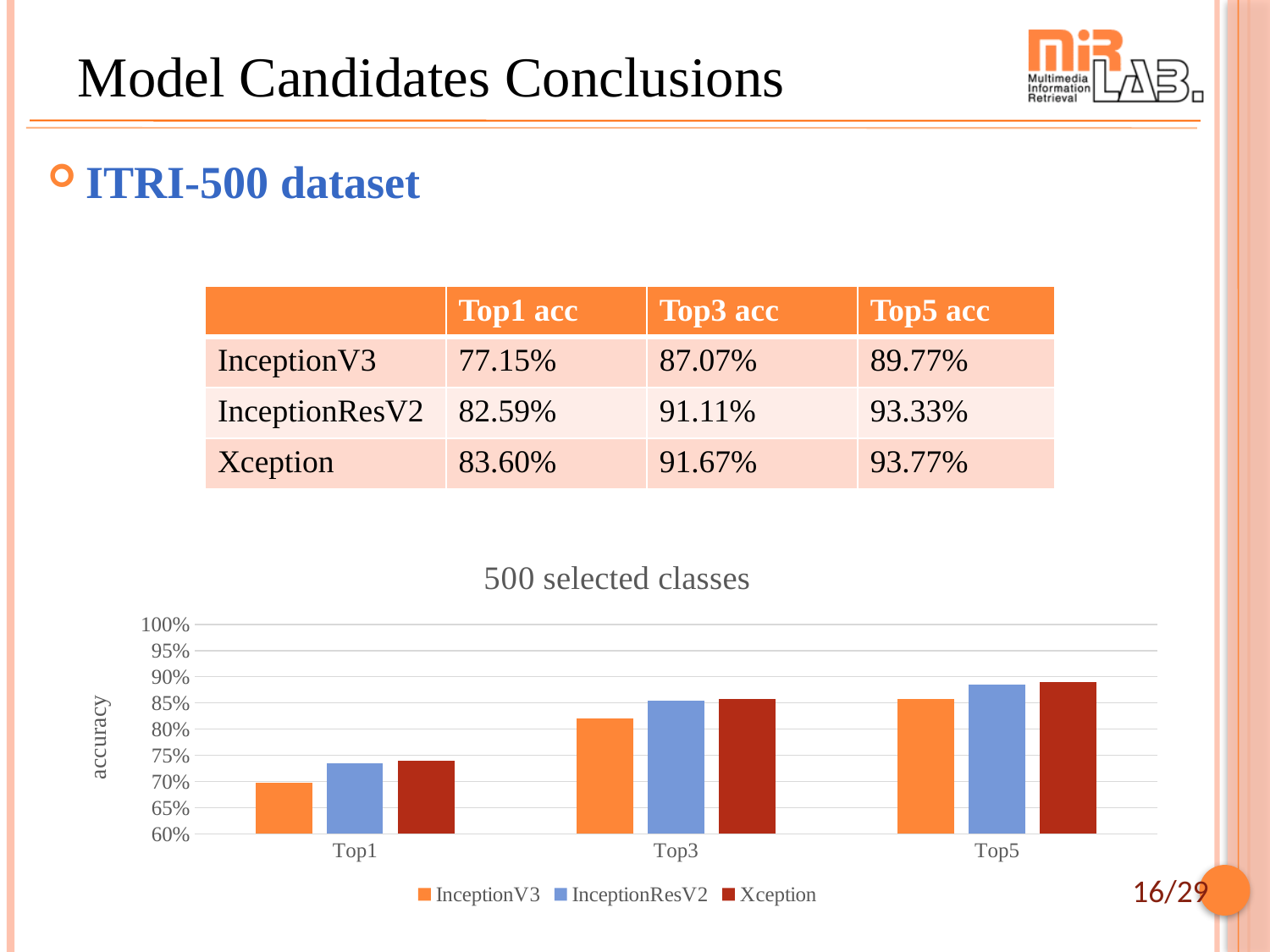
What is the label on the y axis of the "500 selected classes" chart? accuracy What kind of chart is shown under the title "500 selected classes"? bar chart In the "500 selected classes" chart, is the InceptionResV2 bar for Top1 greater or less than 80%? less How many categories are shown on the x axis of the "500 selected classes" chart? 3 In the "500 selected classes" chart, is the InceptionV3 bar for Top3 greater or less than 80%? greater In the "500 selected classes" chart, which series has the lowest bar for Top1? InceptionV3 In the "500 selected classes" chart, is the InceptionV3 bar for Top1 greater or less than 75%? less In the "500 selected classes" chart, do the InceptionV3 bars rise or fall from Top1 to Top5? rise In the "500 selected classes" chart, which series is shown in dark red? Xception How many series does the legend of the "500 selected classes" chart list? 3 In the "500 selected classes" chart, which is larger for Top3: InceptionV3 or Xception? Xception